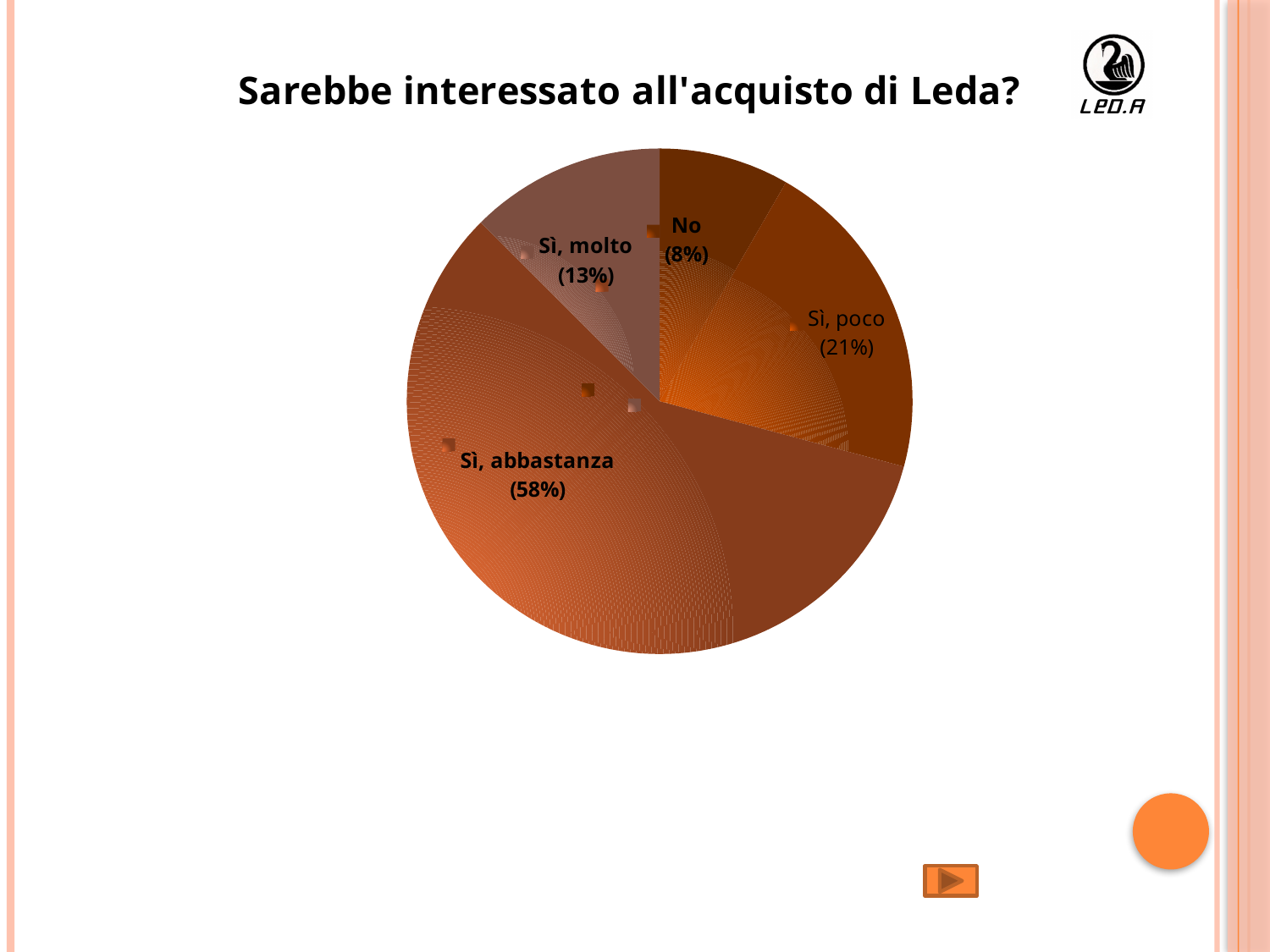
Which category has the largest slice of the pie? Sì, abbastanza What percentage of the pie is the "Sì, molto" slice? 13% What is the title of the chart? Sarebbe interessato all'acquisto di Leda? What percentage of the pie is the "Sì, poco" slice? 21% What percentage of the pie is the "Sì, abbastanza" slice? 58% Which is larger, the "Sì, poco" slice or the "Sì, molto" slice? Sì, poco How many slices does the pie chart have? 4 Which category has the smallest slice of the pie? No What kind of chart is shown on the slide? pie chart What is the difference in percentage points between the "Sì, molto" slice and the "No" slice? 5 What is the difference in percentage points between the "Sì, abbastanza" slice and the "Sì, poco" slice? 37